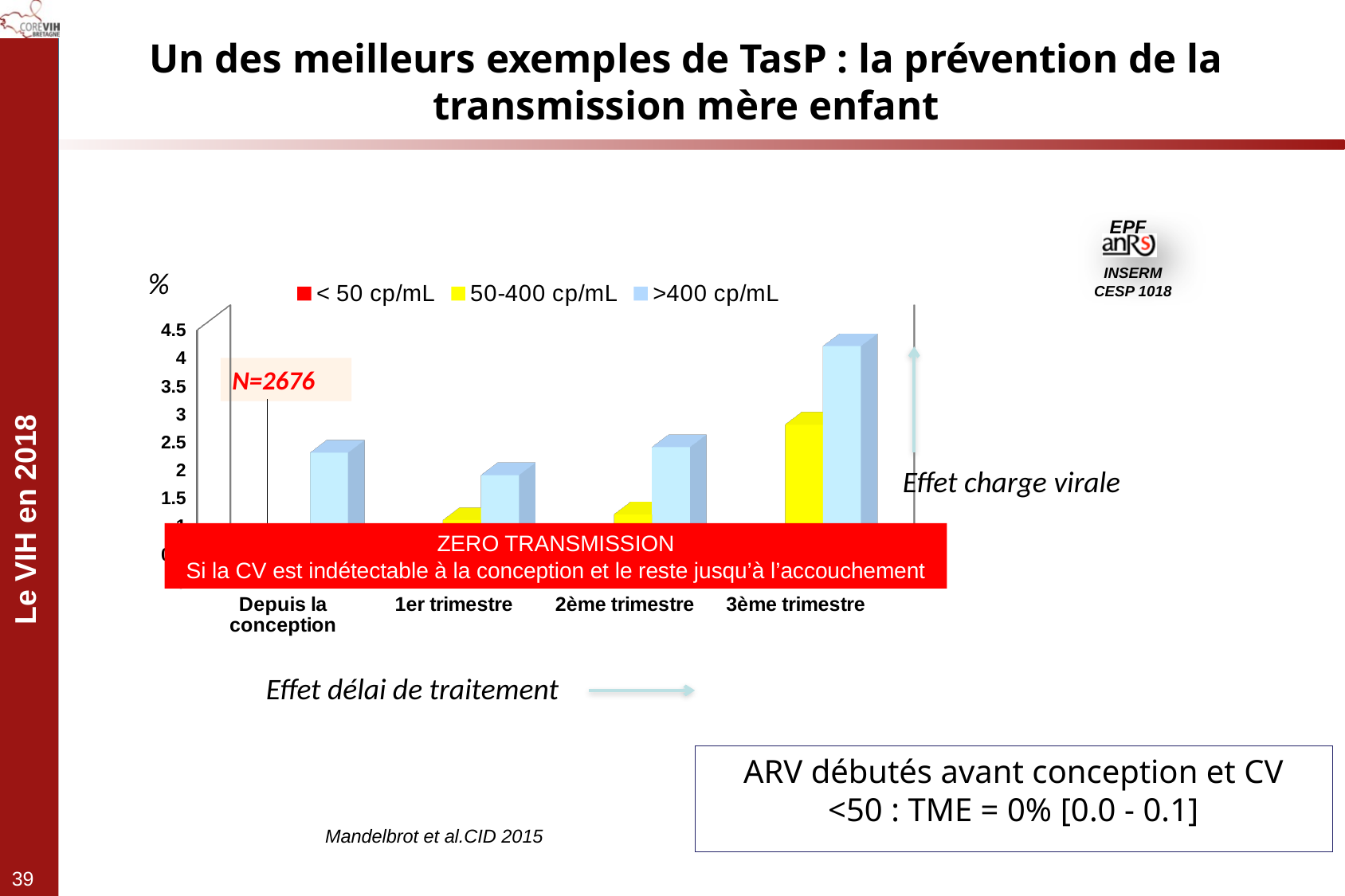
Which colour represents the >400 cp/mL series in the chart legend? light blue For the >400 cp/mL series, which category has the highest bar? 3ème trimestre Is the value for 50-400 cp/mL at 3ème trimestre greater or less than 2? greater Is the value for >400 cp/mL at 3ème trimestre greater or less than 3.5? greater Is the value for >400 cp/mL at 1er trimestre greater or less than 3? less How many categories are shown on the x axis of the chart? 4 For the >400 cp/mL series, which category has the lowest bar? 1er trimestre Which is larger for the >400 cp/mL series: the value at 3ème trimestre or at Depuis la conception? 3ème trimestre What kind of chart is shown on the slide? bar chart At 3ème trimestre, which series has the larger value: 50-400 cp/mL or >400 cp/mL? >400 cp/mL What sample size (N) is annotated on the chart? N=2676 How many series does the chart legend list? 3